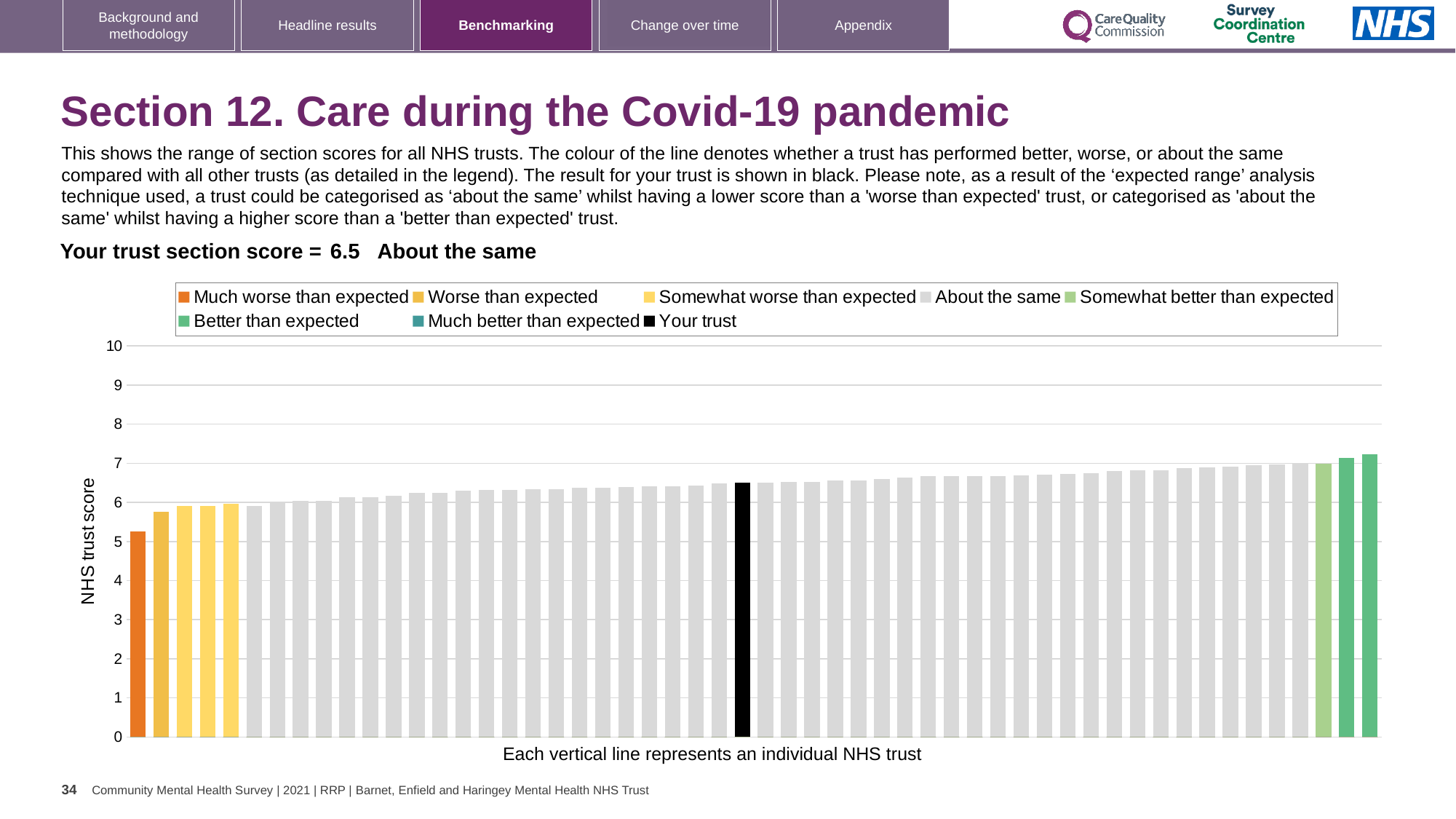
What is the section score for your trust shown on the slide? 6.5 Which legend category does the tallest bar in the chart belong to? Better than expected Do the bar values rise or fall from left to right along the x axis? rise How many bars are coloured as 'Better than expected' in the chart? 2 Which legend category does the shortest bar in the chart belong to? Much worse than expected Is the value of the tallest bar in the chart greater or less than 7? greater Is the value of the shortest bar in the chart greater or less than 5? greater What kind of chart is shown on the slide? bar chart Is the value for the 'Much worse than expected' bar greater or less than 6? less How many entries does the chart legend list? 8 Which is larger: the 'Your trust' bar or the 'Much worse than expected' bar? Your trust